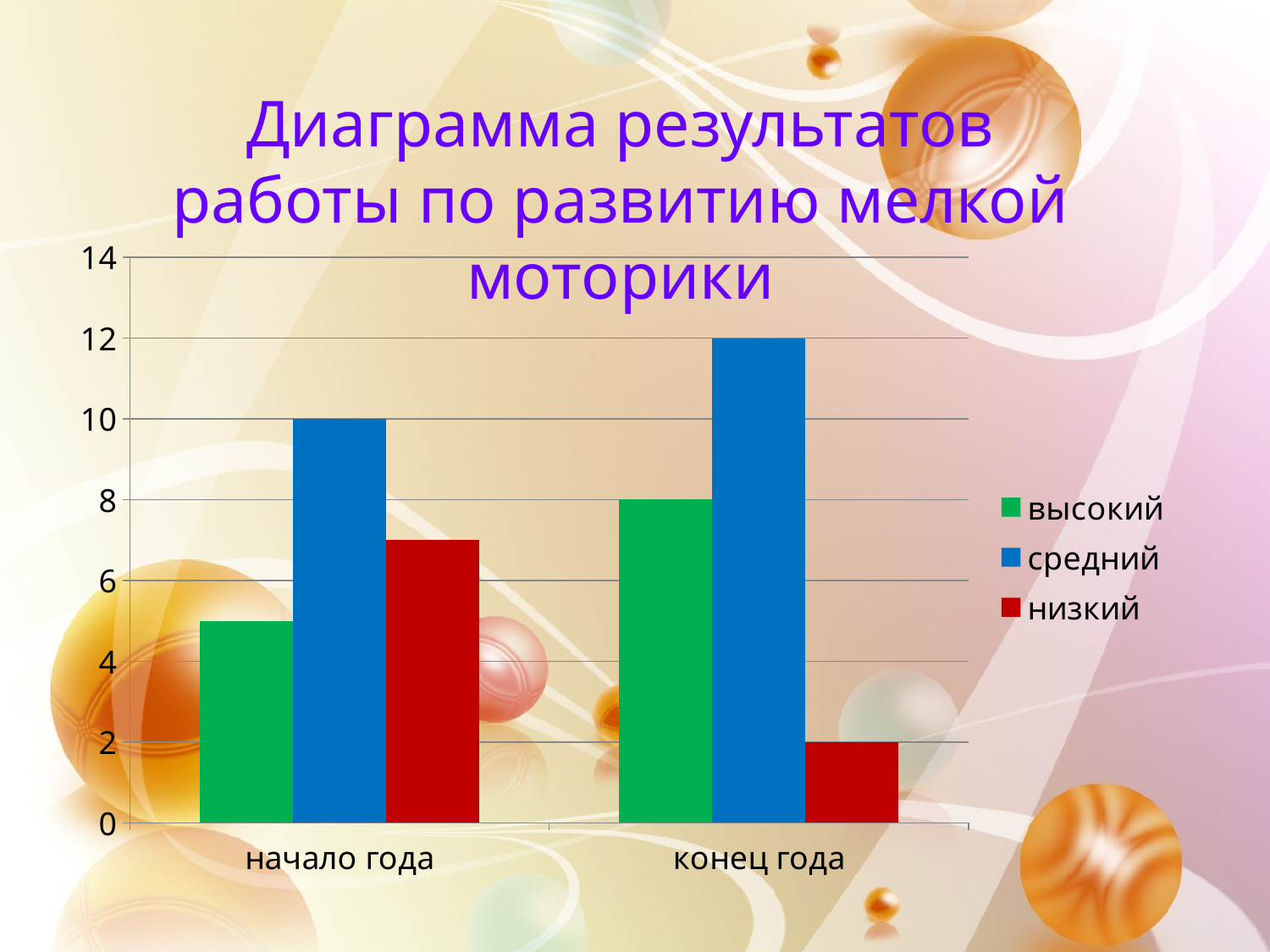
What kind of chart is shown on the slide? bar chart What is the value for высокий at конец года? 8 Is the value for высокий at начало года greater or less than 4? greater What is the value for низкий at конец года? 2 Which series has the lowest bar at конец года? низкий How many categories are shown on the x axis? 2 How many series does the legend list? 3 Which series has the highest bar at конец года? средний What is the value for средний at конец года? 12 By how much does the value for средний increase from начало года to конец года? 2 Does the value for низкий rise or fall from начало года to конец года? fall What is the value for средний at начало года? 10